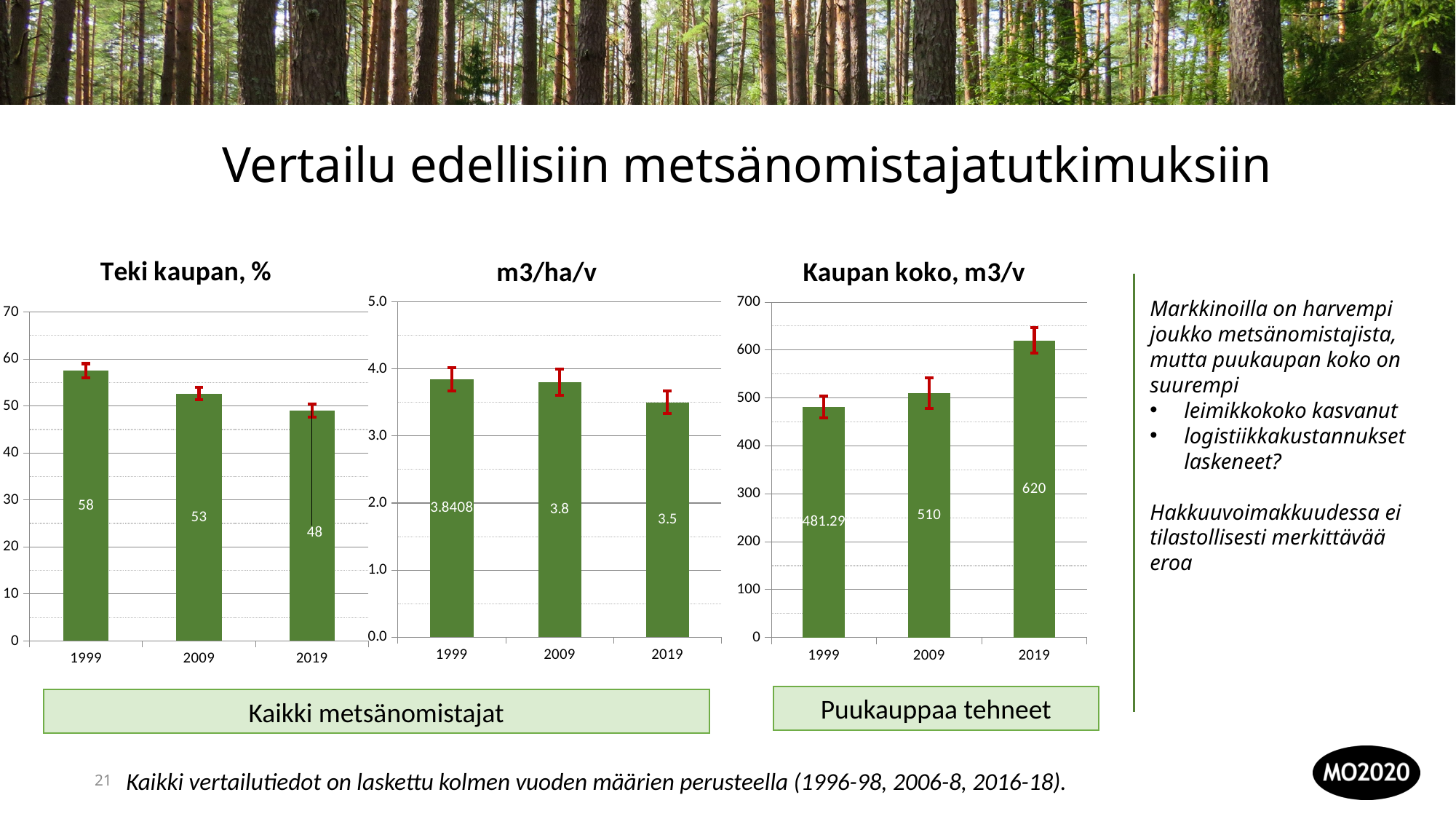
In the 'Teki kaupan, %' chart, which year has the lowest value? 2019 In the 'Teki kaupan, %' chart, what is the difference between the 1999 and 2019 values? 10 In the 'm3/ha/v' chart, is the value for 2009 greater or less than 3.0? greater In the 'Teki kaupan, %' chart, do the values rise or fall from 1999 to 2019? fall In the 'Teki kaupan, %' chart, what is the value for 2009? 53 In the 'm3/ha/v' chart, what is the value for 2019? 3.5 In the 'Kaupan koko, m3/v' chart, what is the value for 2019? 620 In the 'Kaupan koko, m3/v' chart, which year has the highest value? 2019 In the 'Kaupan koko, m3/v' chart, which is larger, the value for 1999 or the value for 2009? 2009 How many charts are shown on the slide, and what type are they? 3 bar charts In the 'Kaupan koko, m3/v' chart, what is the difference between the 2019 and 2009 values? 110 In the 'm3/ha/v' chart, what is the value for 1999? 3.8408